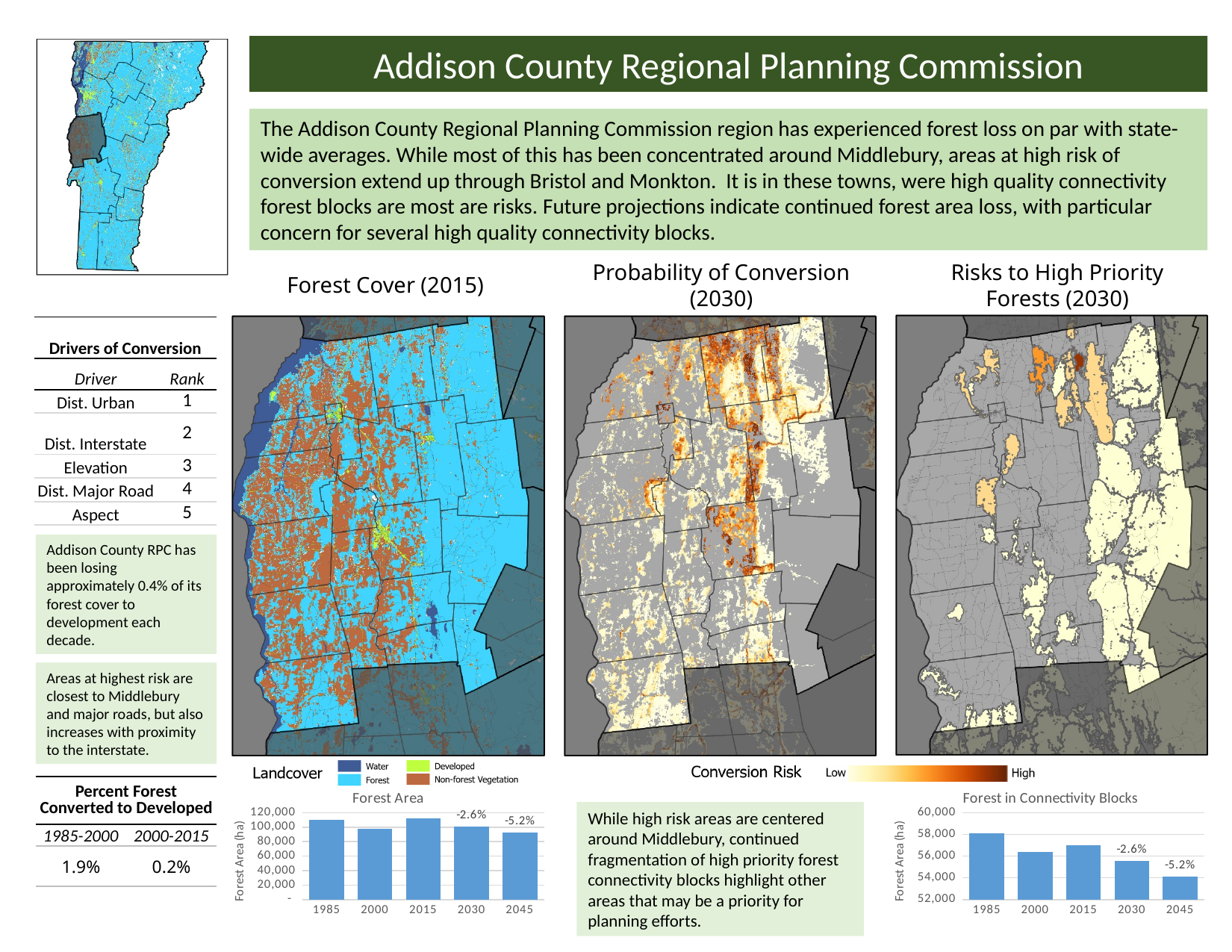
On the "Forest Area" chart, is the value for 1985 greater or less than 100,000? greater How many years are plotted on the "Forest Area" chart? 5 What kind of chart is the "Forest Area" chart at the bottom left of the slide? bar chart On the "Forest in Connectivity Blocks" chart, which year has the lowest forest area? 2045 On the "Forest in Connectivity Blocks" chart, what percentage change label is shown above the 2030 bar? -2.6% On the "Forest Area" chart, which is larger, the value for 2015 or the value for 2045? 2015 On the "Forest Area" chart, what percentage change label is shown above the 2045 bar? -5.2% On the "Forest Area" chart, is the value for 2000 greater or less than 100,000? less What is the y-axis label on the "Forest in Connectivity Blocks" chart? Forest Area (ha) On the "Forest in Connectivity Blocks" chart, is the value for 2045 greater or less than 56,000? less On the "Forest Area" chart, what percentage change label is shown above the 2030 bar? -2.6% On the "Forest in Connectivity Blocks" chart, which year has the highest forest area? 1985